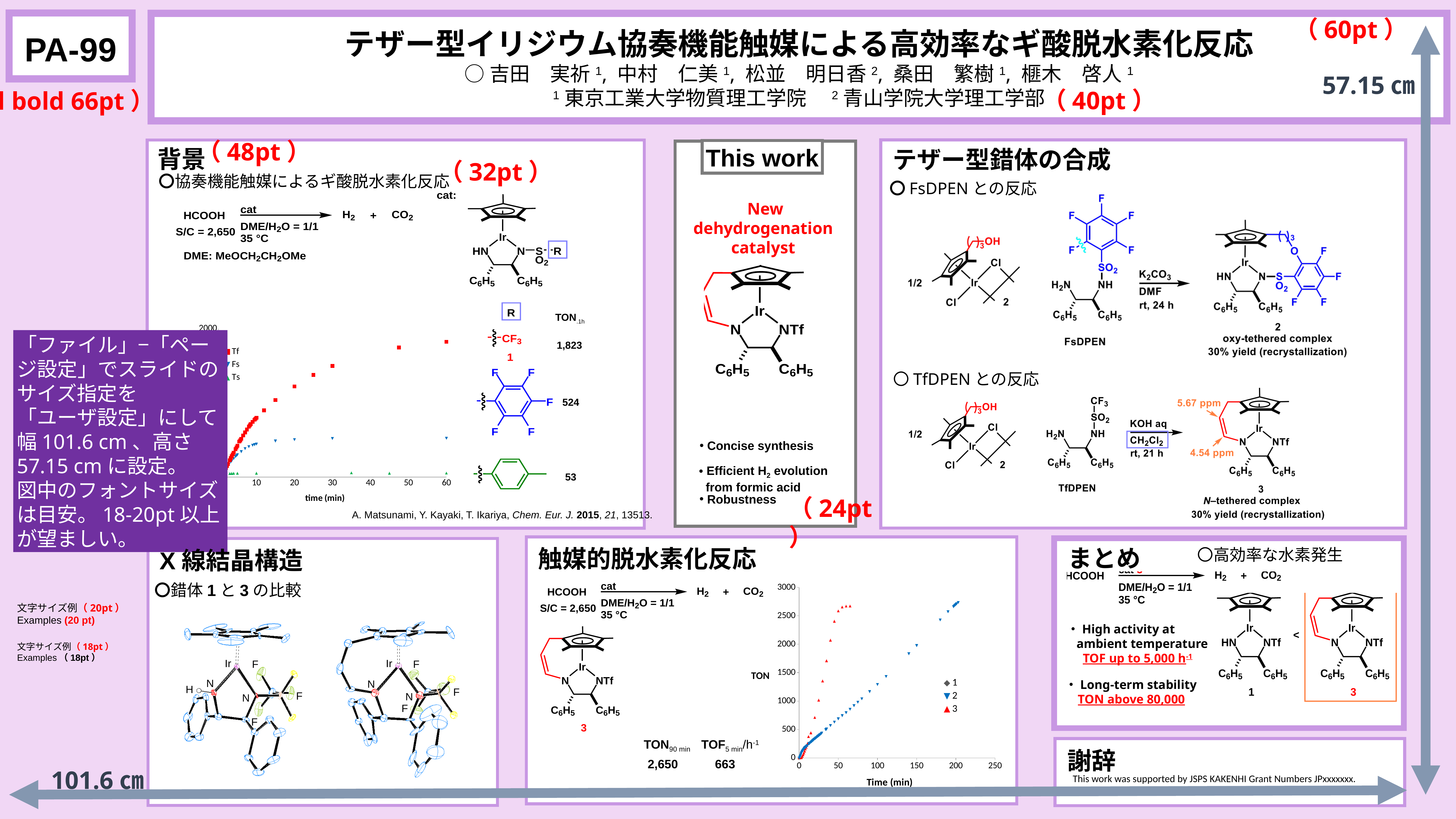
What kind of chart is shown in the 触媒的脱水素化反応 section? scatter chart On the chart in the 触媒的脱水素化反応 section, at 50 min, is the TON for series 3 greater or less than 2000? greater On the chart in the 触媒的脱水素化反応 section, at 100 min, is the TON for series 2 greater or less than 1500? less On the chart in the 触媒的脱水素化反応 section, does the TON for series 3 rise or fall as time increases? rise On the chart in the 触媒的脱水素化反応 section, what are the legend entries? 1, 2, 3 On the chart in the 背景 section, how many series does the legend list? 3 On the chart in the 触媒的脱水素化反応 section, what is the label of the x axis? Time (min) On the chart in the 触媒的脱水素化反応 section, which series reaches a TON of 2500 in the shortest time? 3 On the chart in the 触媒的脱水素化反応 section, at 50 min, which series has the larger TON, 2 or 3? 3 On the chart in the 背景 section, which series has the highest TON at 60 min? Tf On the chart in the 触媒的脱水素化反応 section, how many series does the legend list? 3